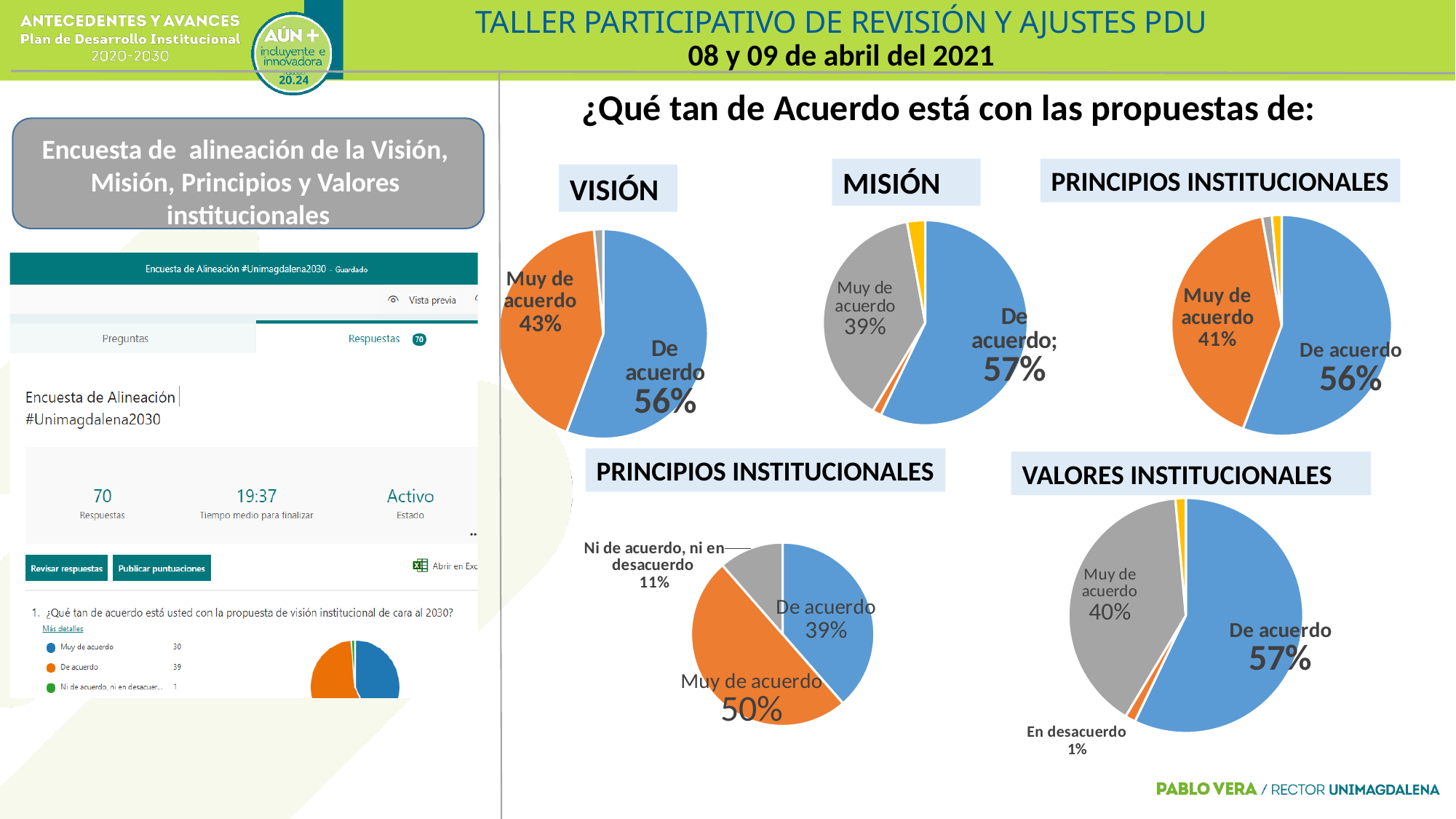
In the VALORES INSTITUCIONALES pie chart, what is the difference between the "De acuerdo" and "Muy de acuerdo" shares? 17% In the VISIÓN pie chart, what share of respondents answered "De acuerdo"? 56% In the PRINCIPIOS INSTITUCIONALES pie chart at the top right, what is the difference between the "De acuerdo" and "Muy de acuerdo" shares? 15% What type of chart is used for the VISIÓN, MISIÓN and VALORES INSTITUCIONALES results? Pie chart In the PRINCIPIOS INSTITUCIONALES pie chart at the bottom left, which is larger: "De acuerdo" or "Muy de acuerdo"? Muy de acuerdo In the VALORES INSTITUCIONALES pie chart, what percentage is labelled "En desacuerdo"? 1% In the PRINCIPIOS INSTITUCIONALES pie chart at the top right, what percentage is labelled "De acuerdo"? 56% In the PRINCIPIOS INSTITUCIONALES pie chart at the bottom left, what percentage is labelled "Muy de acuerdo"? 50% In the MISIÓN pie chart, what percentage is labelled "Muy de acuerdo"? 39% In the MISIÓN pie chart, which labelled slice is the largest? De acuerdo In the PRINCIPIOS INSTITUCIONALES pie chart at the bottom left, what share is labelled "Ni de acuerdo, ni en desacuerdo"? 11% In the VISIÓN pie chart, what share of respondents answered "Muy de acuerdo"? 43%